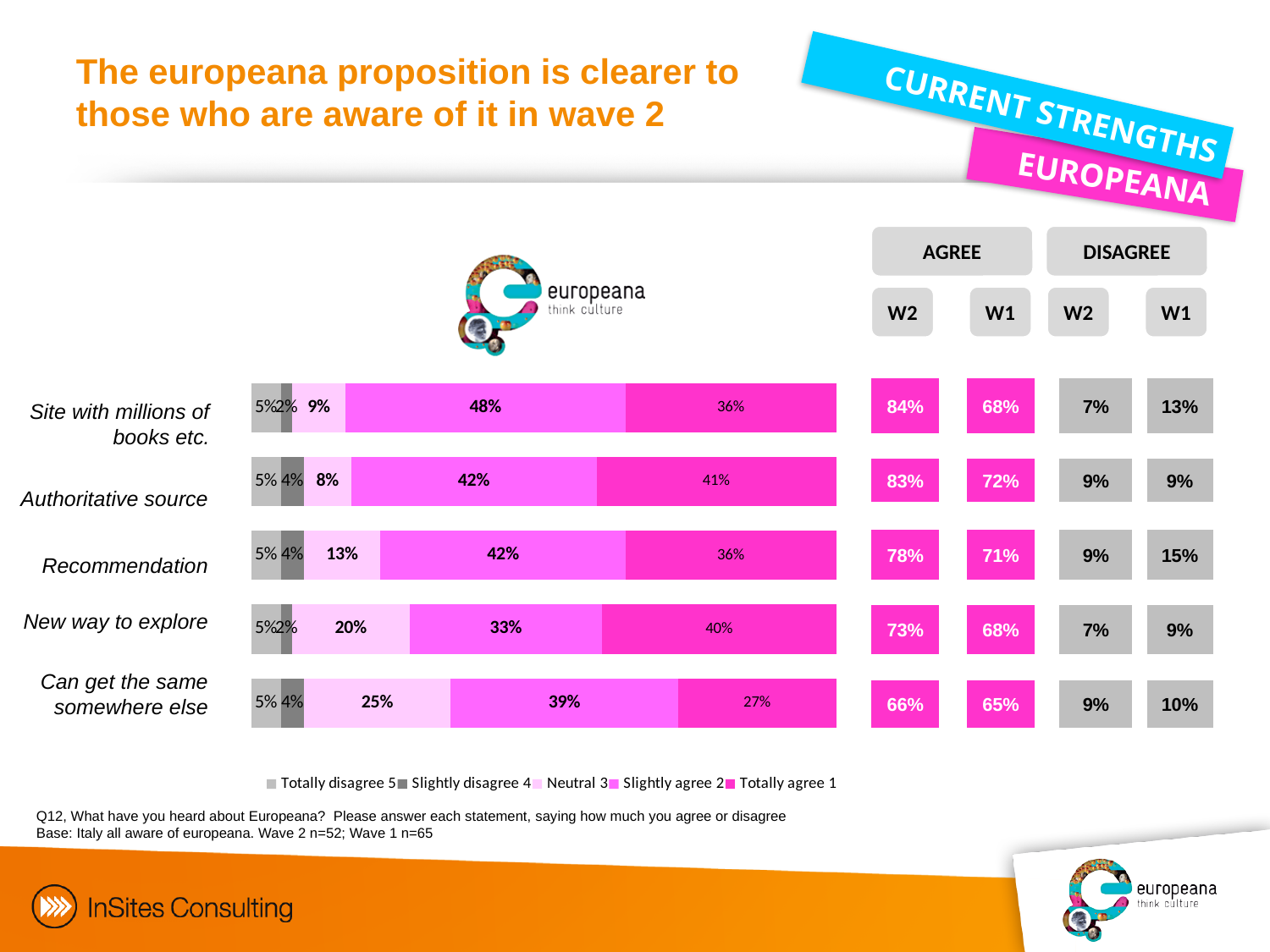
What is the Neutral value for Can get the same somewhere else? 25% Which has the larger Totally agree value: Site with millions of books etc. or New way to explore? New way to explore What is the difference between the Slightly agree and Totally agree values for Site with millions of books etc.? 12 percentage points What is the Totally agree value for Authoritative source? 41% What is the Slightly agree value for New way to explore? 33% What is the first entry in the chart legend? Totally disagree 5 What is the Slightly disagree value for Recommendation? 4% How many categories (statements) are shown in the bar chart? 5 How many series does the legend list? 5 Which category has the lowest Slightly agree value? New way to explore Which category has the highest Neutral value? Can get the same somewhere else What kind of chart is shown on the slide? Stacked bar chart